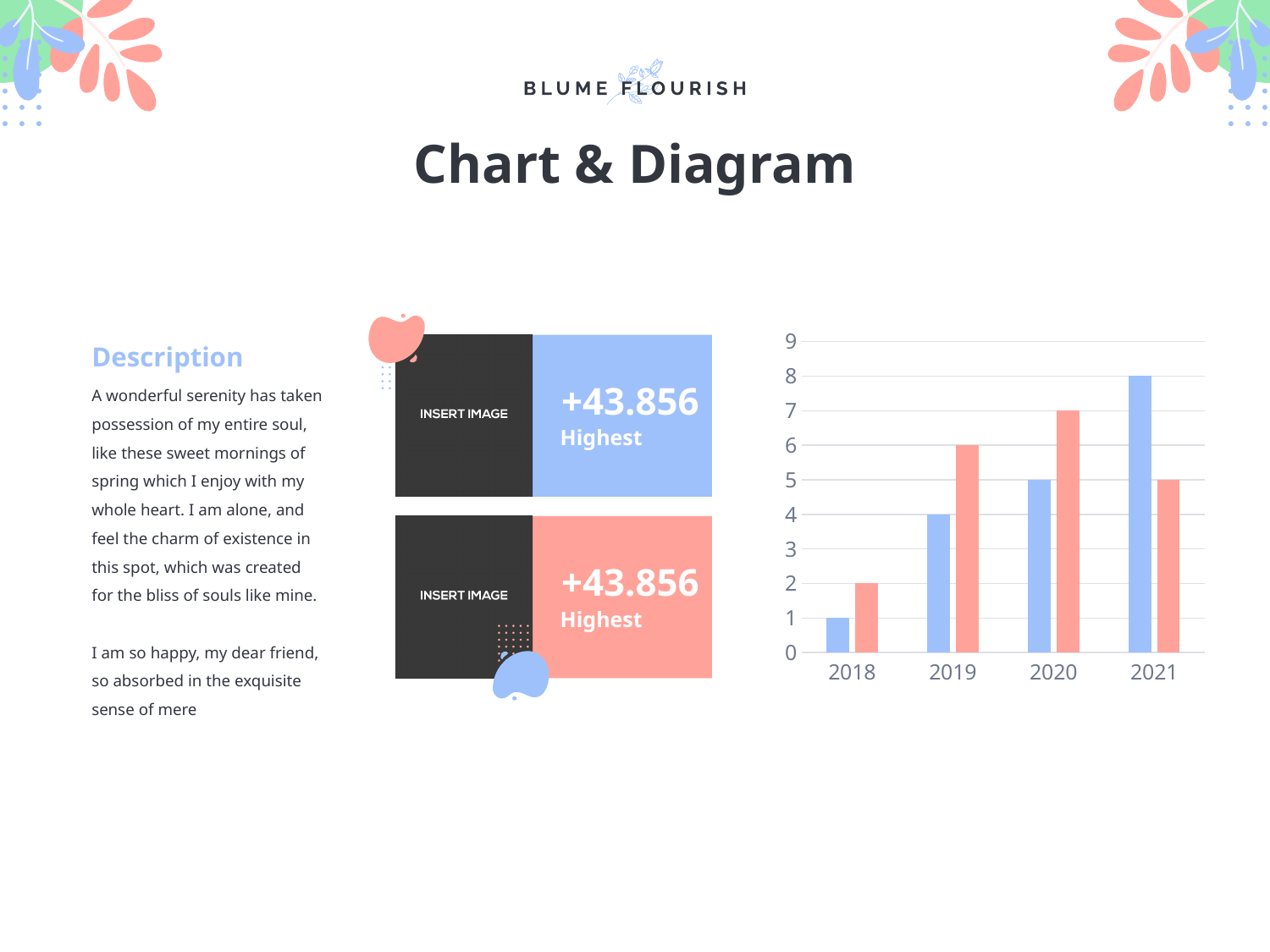
What is the value of the blue bar for 2018? 1 What is the value of the pink bar for 2019? 6 In which year is the pink bar lowest? 2018 What is the value of the pink bar for 2020? 7 What kind of chart is shown on the slide? bar chart What is the difference between the pink bar and the blue bar in 2019? 2 Do the blue bars rise or fall from 2018 to 2021? rise In 2021, which bar is taller, the blue one or the pink one? the blue one In which year is the blue bar highest? 2021 What is the value of the blue bar for 2021? 8 What is the highest value shown on the y axis of the bar chart? 9 How many years are shown on the x axis of the bar chart? 4